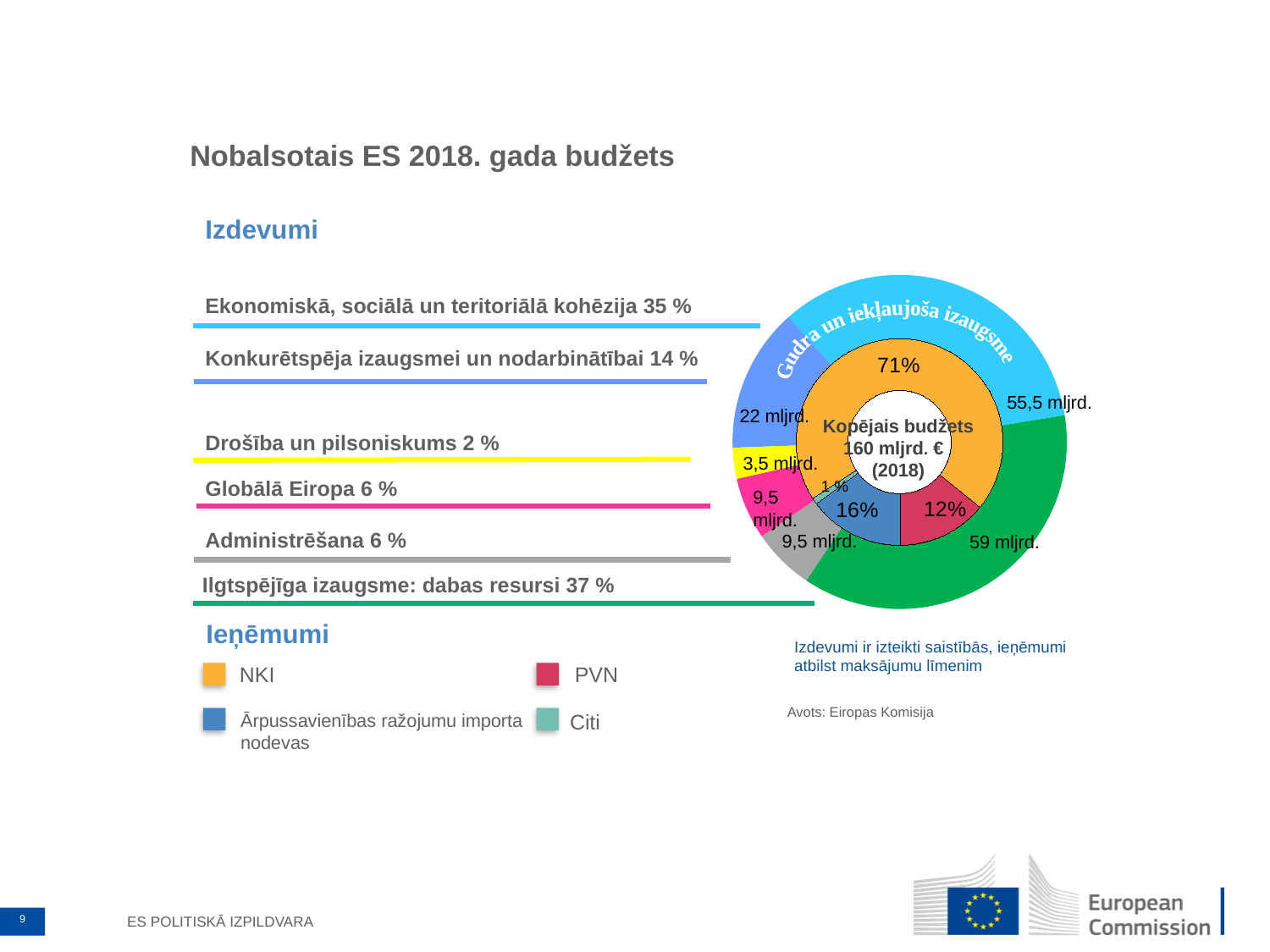
What total budget is printed in the centre of the chart? 160 mljrd. € Which expenditure category has the largest share according to the list on the slide? Ilgtspējīga izaugsme: dabas resursi What percentage is shown for PVN in the inner ring? 12% What value is printed on the light blue outer segment (Ekonomiskā, sociālā un teritoriālā kohēzija)? 55,5 mljrd. What kind of chart is shown on the slide? doughnut chart Which revenue source has the smallest share in the inner ring? Citi What is the difference between the green segment (59 mljrd.) and the light blue segment (55,5 mljrd.)? 3,5 mljrd. What value is printed on the yellow outer segment (Drošība un pilsoniskums)? 3,5 mljrd. What value is printed on the green outer segment (Ilgtspējīga izaugsme: dabas resursi)? 59 mljrd. What percentage is shown for NKI in the inner ring? 71% Which is larger in the inner ring: the share for Ārpussavienības ražojumu importa nodevas or the share for PVN? Ārpussavienības ražojumu importa nodevas How many revenue sources are listed in the Ieņēmumi legend? 4